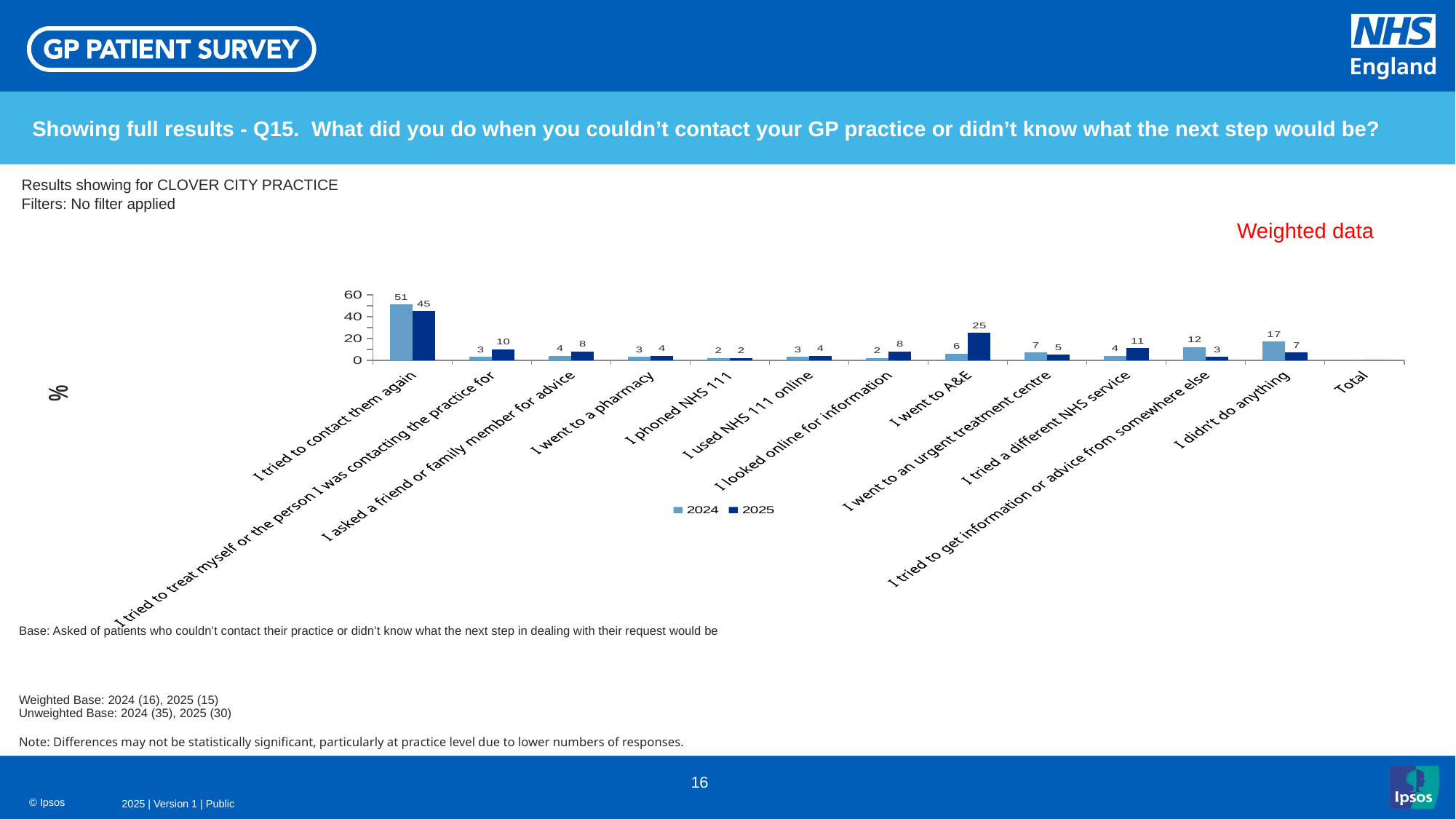
What kind of chart is shown on the slide? Bar chart How many series does the legend list? 2 Which category has the highest 2025 value? I tried to contact them again What is the 2024 value for "I didn't do anything"? 17 What is the 2025 value for "I tried a different NHS service"? 11 Which year does the darker blue series represent? 2025 Is the 2025 value for "I tried to contact them again" greater or less than 40? greater Which category has the lowest 2024 value? I phoned NHS 111 (tied with I looked online for information) What is the difference between the 2024 and 2025 values for "I went to A&E"? 19 What is the 2025 value for "I went to A&E"? 25 Which is larger for "I tried to get information or advice from somewhere else": the 2024 value or the 2025 value? 2024 What is the 2024 value for "I tried to contact them again"? 51